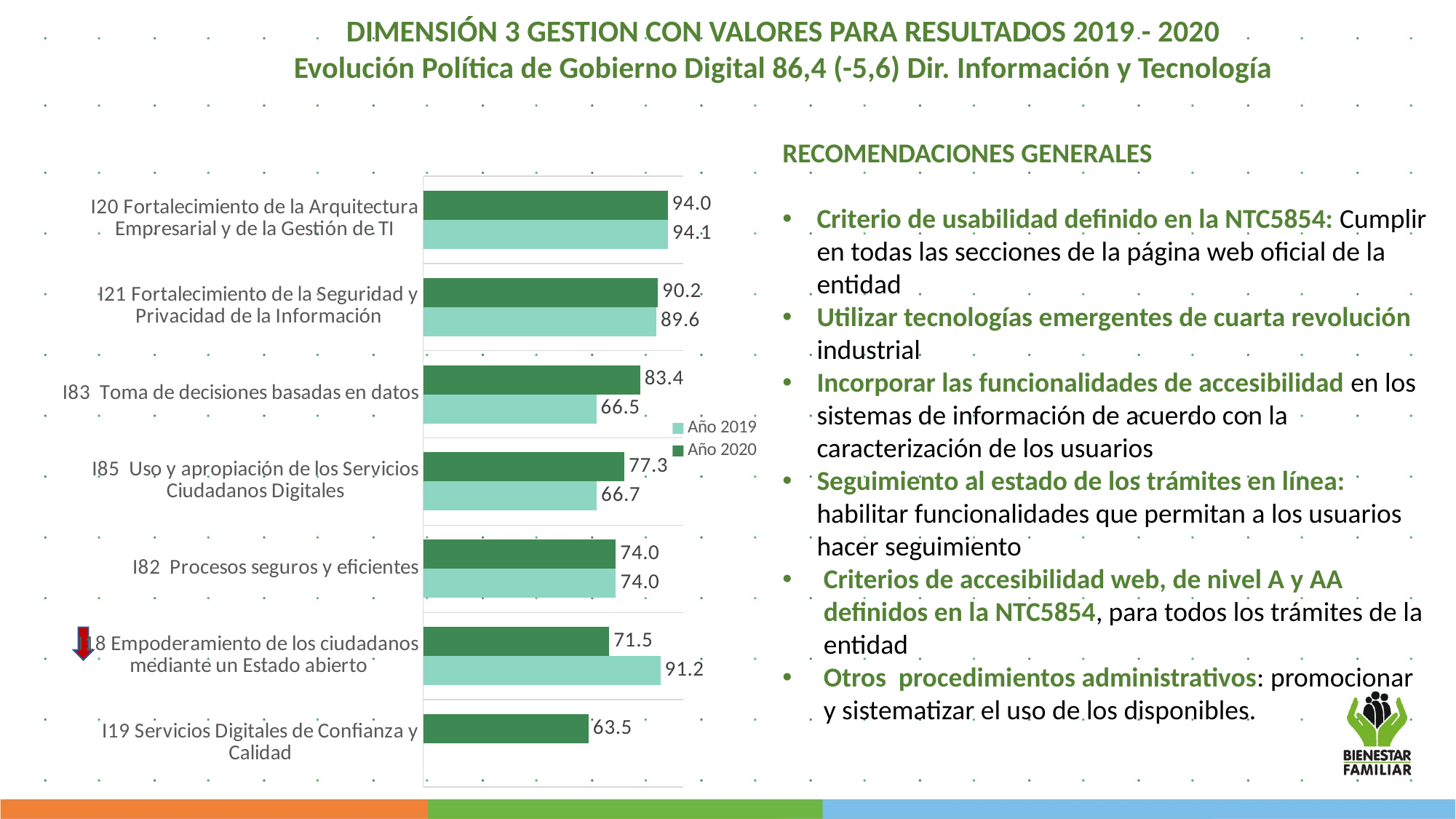
What is the Año 2020 value for I83 Toma de decisiones basadas en datos? 83.4 What is the Año 2020 value for I19 Servicios Digitales de Confianza y Calidad? 63.5 What is the Año 2019 value for I18 Empoderamiento de los ciudadanos mediante un Estado abierto? 91.2 What is the Año 2019 value for I82 Procesos seguros y eficientes? 74.0 For I18 Empoderamiento de los ciudadanos mediante un Estado abierto, which is larger: the Año 2019 value or the Año 2020 value? Año 2019 Which category has the highest Año 2020 value? I20 Fortalecimiento de la Arquitectura Empresarial y de la Gestión de TI Which category has the lowest Año 2020 value? I19 Servicios Digitales de Confianza y Calidad How many categories (indicators) are shown on the chart? 7 How many series does the chart legend list? 2 What type of chart is shown on the slide? bar chart What are the two series named in the chart legend? Año 2019 and Año 2020 What is the difference between the Año 2020 and Año 2019 values for I83 Toma de decisiones basadas en datos? 16.9